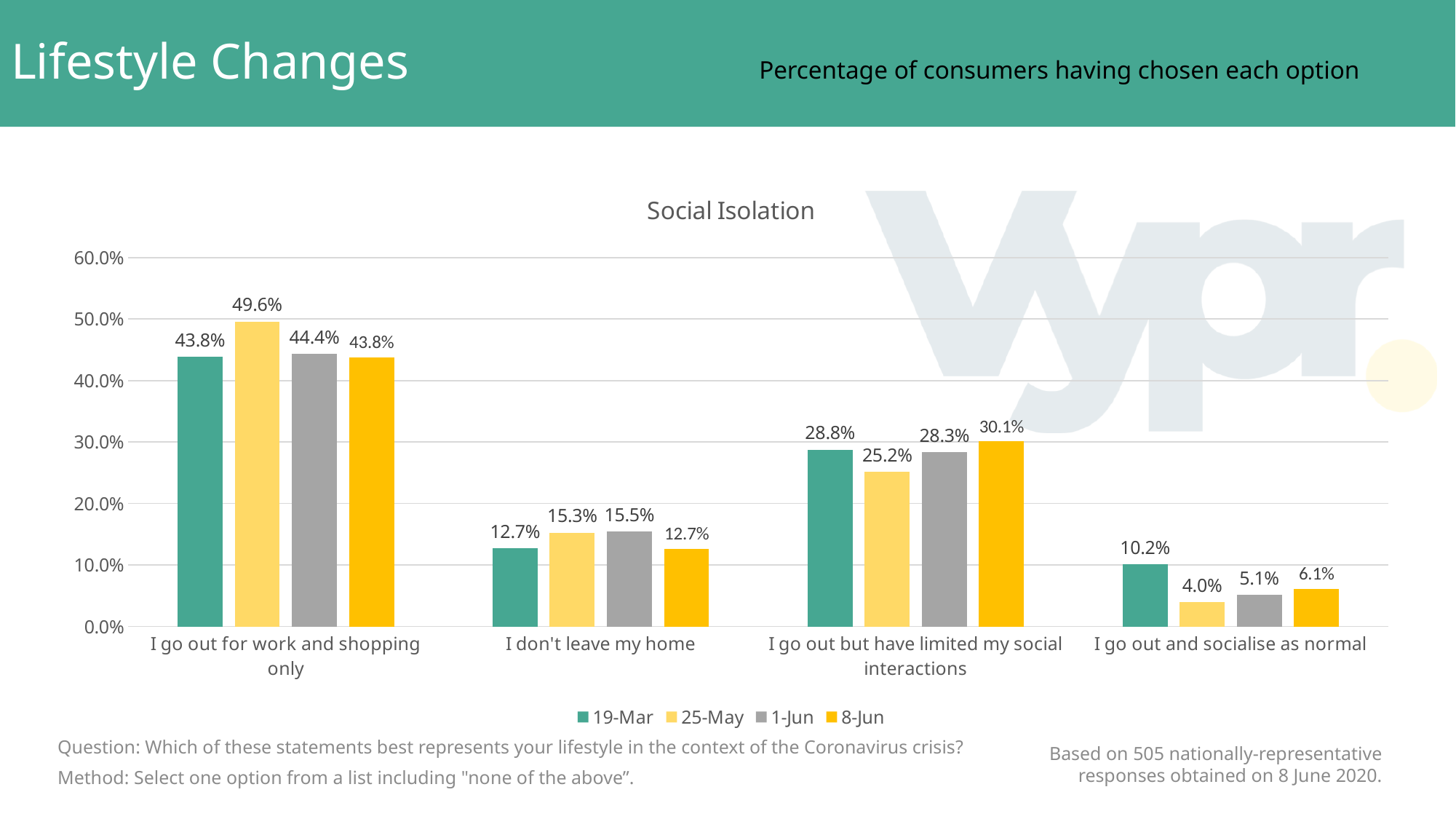
What is the value for "I go out but have limited my social interactions" in the 8-Jun series? 30.1% For "I go out but have limited my social interactions", which is larger: the 19-Mar value or the 25-May value? 19-Mar What is the value for "I go out and socialise as normal" in the 19-Mar series? 10.2% What is the title of the chart? Social Isolation What kind of chart is shown on the slide? Bar chart How many categories are shown on the x axis? 4 How many series does the legend list? 4 Which category has the lowest value in the 25-May series? I go out and socialise as normal What is the value for "I go out for work and shopping only" in the 25-May series? 49.6% What is the value for "I don't leave my home" in the 1-Jun series? 15.5% Which category has the highest value in the 8-Jun series? I go out for work and shopping only What is the difference between the 25-May and 8-Jun values for "I go out for work and shopping only"? 5.8%